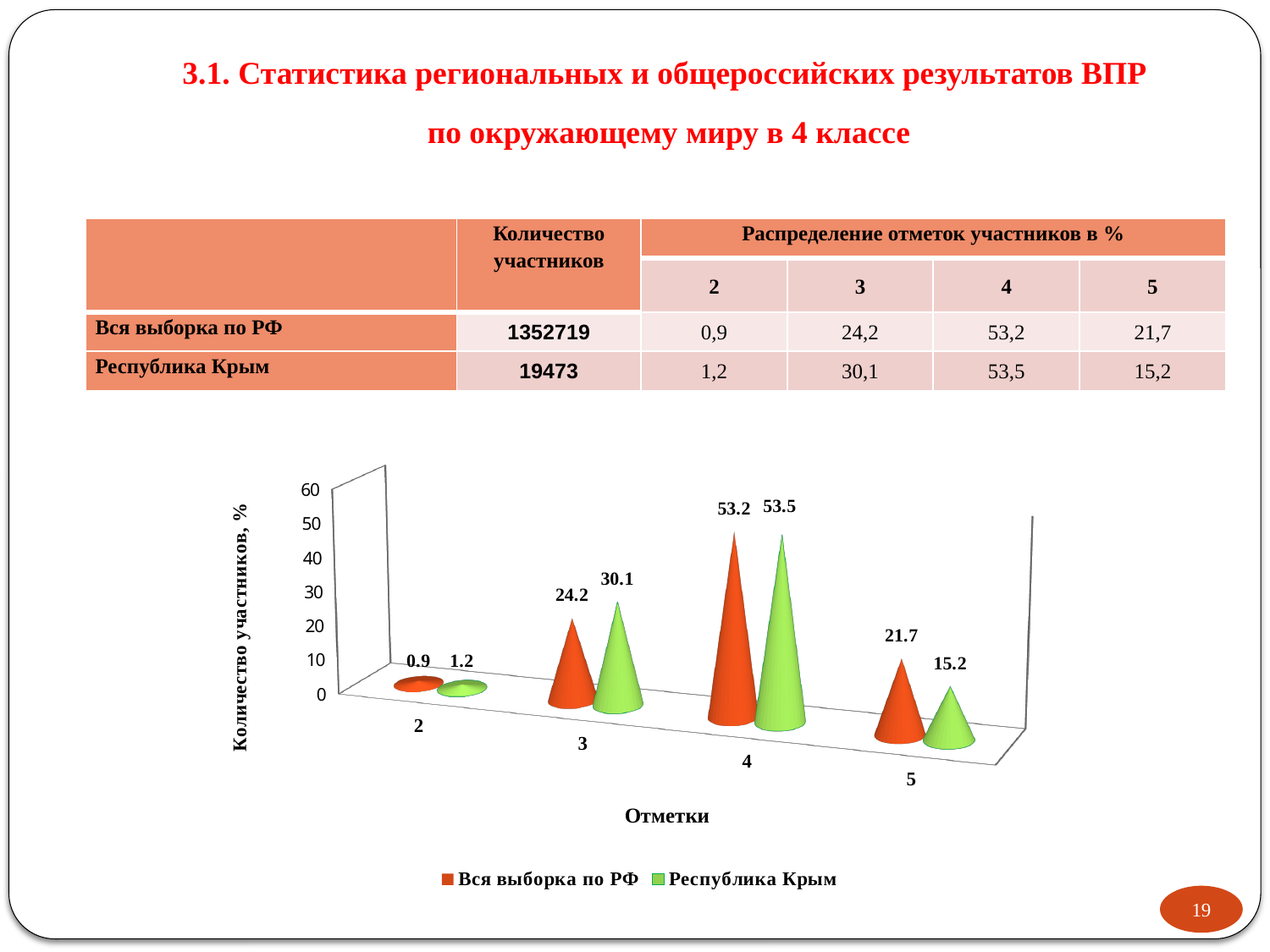
What is the label of the x axis? Отметки What is the value for "Республика Крым" at mark 2? 1.2 Is the value for "Республика Крым" at mark 4 greater or less than 50? greater How many mark categories are shown on the x axis? 4 What kind of chart is shown on the slide? bar chart Which mark has the highest value for "Вся выборка по РФ"? 4 Which mark has the lowest value for "Республика Крым"? 2 What is the value for "Республика Крым" at mark 5? 15.2 What is the value for "Вся выборка по РФ" at mark 3? 24.2 At mark 5, which series has the larger value: "Вся выборка по РФ" or "Республика Крым"? Вся выборка по РФ How many series does the legend list? 2 What is the difference between "Республика Крым" and "Вся выборка по РФ" at mark 3? 5.9